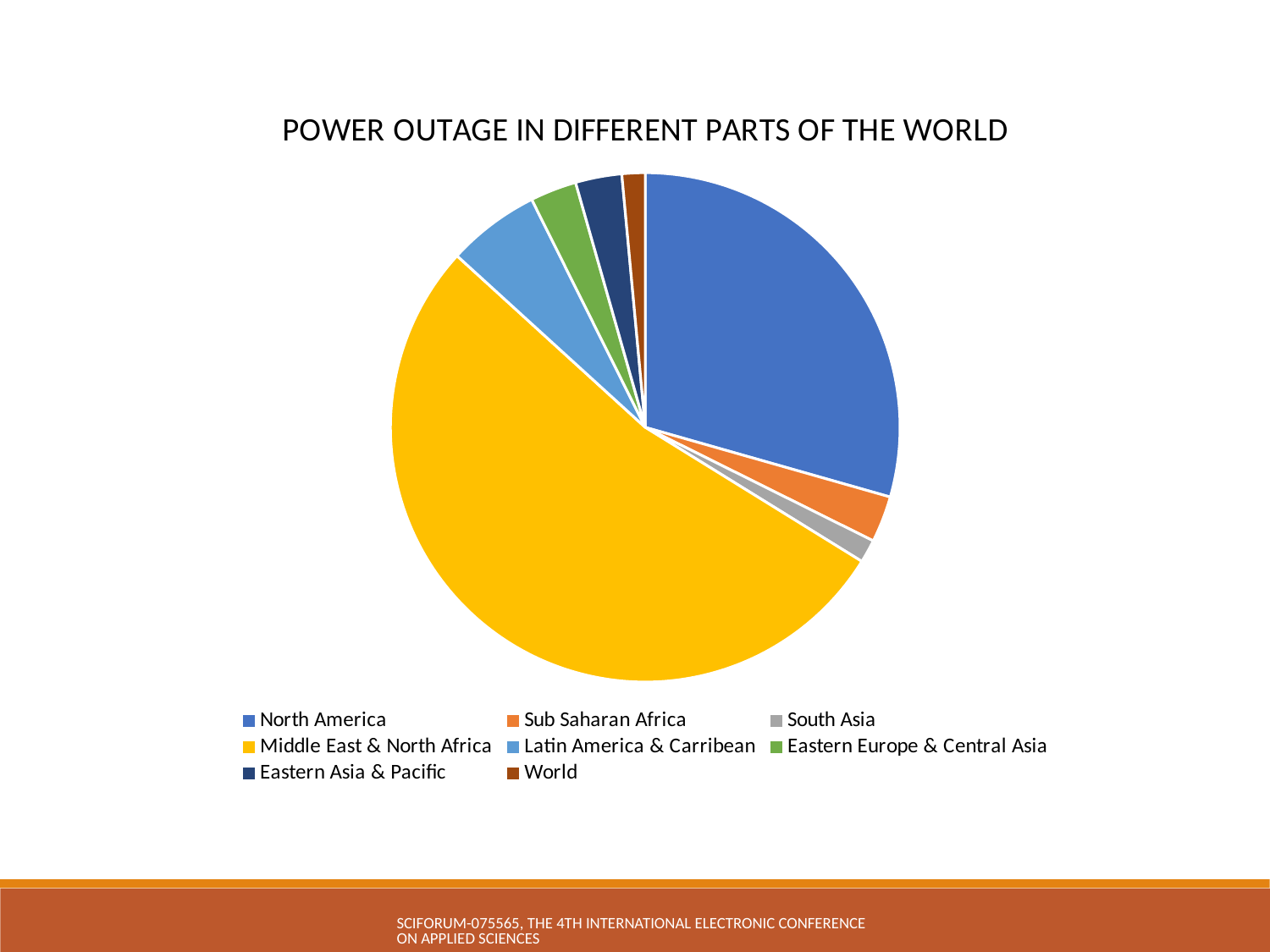
Which region has the second-largest slice of the pie? North America Which slice is larger, Latin America & Carribean or Eastern Asia & Pacific? Latin America & Carribean Which slice is larger, Latin America & Carribean or Eastern Europe & Central Asia? Latin America & Carribean What kind of chart is shown on the slide? pie chart How many slices does the pie chart have? 8 Which region has the largest slice of the pie? Middle East & North Africa Which slice is larger, North America or Latin America & Carribean? North America What is the title of the chart? POWER OUTAGE IN DIFFERENT PARTS OF THE WORLD How many entries does the legend list? 8